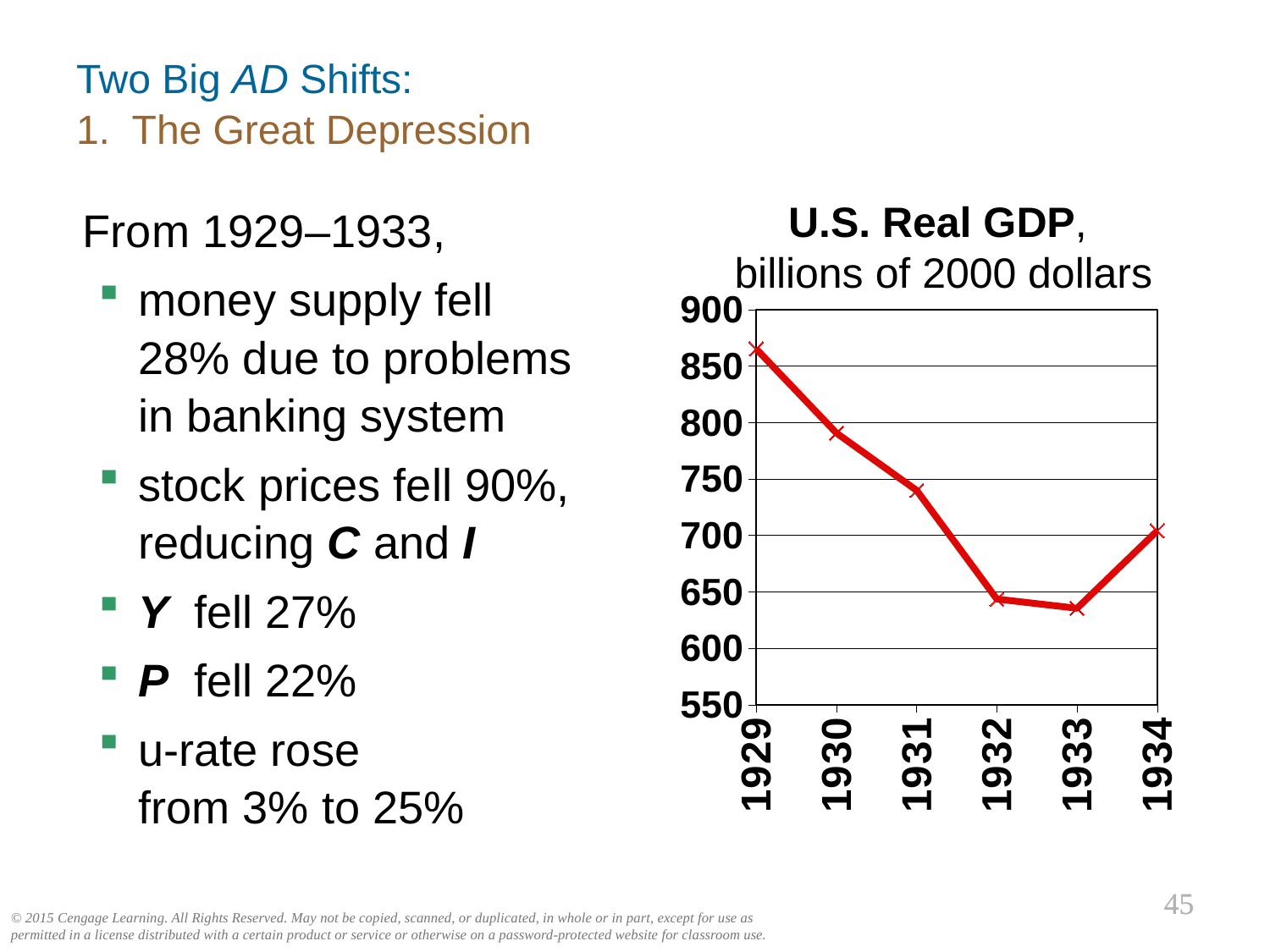
Which year has the highest U.S. Real GDP in the chart? 1929 Which is larger, the value for 1929 or the value for 1934? 1929 Is the value for 1931 greater or less than 800? less Is the value for 1929 greater or less than 800? greater Does U.S. Real GDP rise or fall from 1929 to 1933? fall Is the value for 1934 greater or less than 650? greater What kind of chart is shown on the slide? line chart What is the title of the chart? U.S. Real GDP, billions of 2000 dollars How many years are plotted on the x axis of the chart? 6